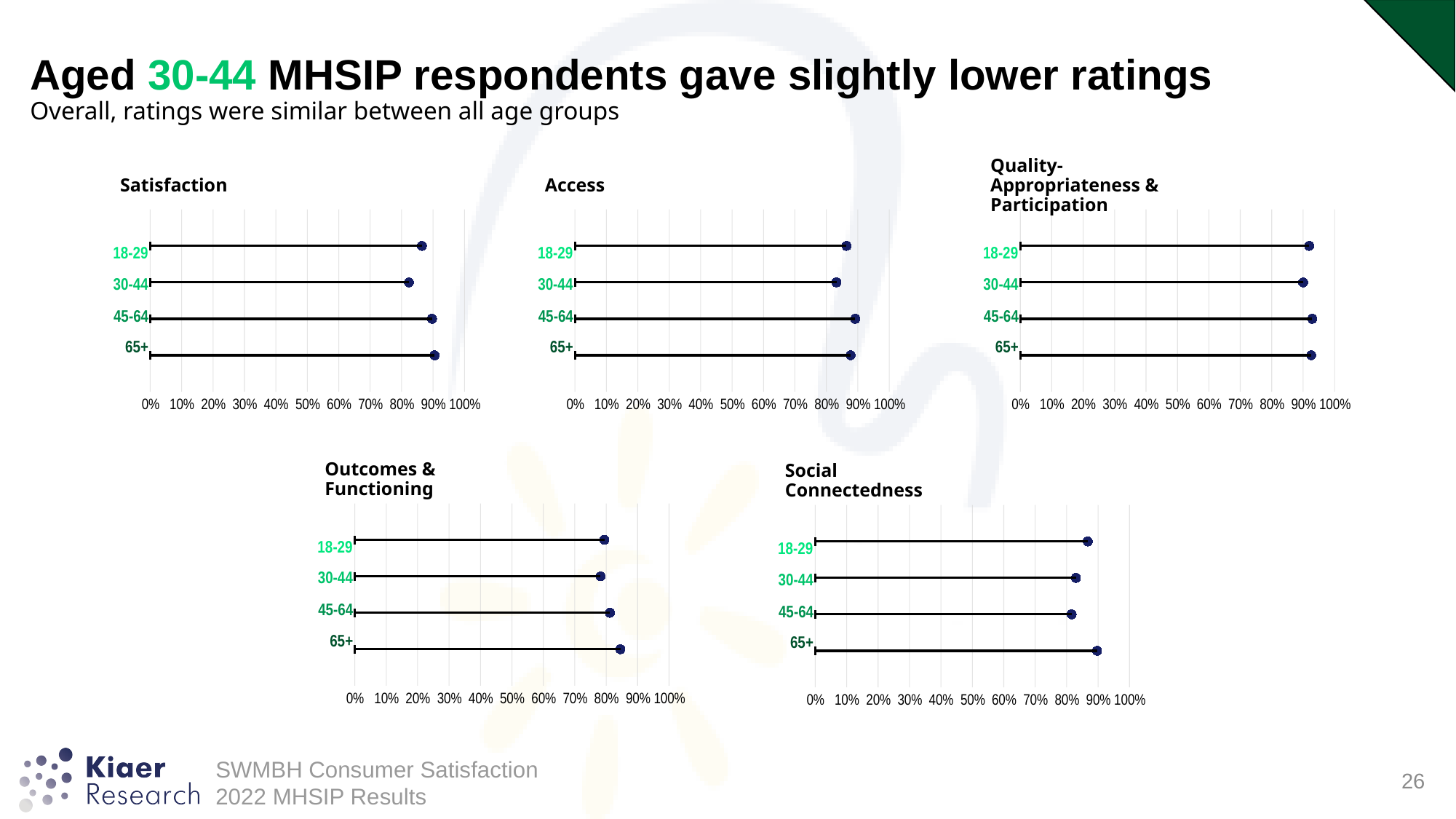
In the Social Connectedness chart, is the value for 45-64 greater or less than 90%? less In the Access chart, is the value for 45-64 greater or less than 70%? greater In the Outcomes & Functioning chart, which age group has the highest rating? 65+ How many age groups are shown in the Satisfaction chart? 4 In the Outcomes & Functioning chart, is the value for 30-44 greater or less than 90%? less In the Access chart, which age group has the lowest rating? 30-44 In the Social Connectedness chart, which age group has the highest rating? 65+ What kind of chart is the Access chart? lollipop chart (dot plot with lines) In the Satisfaction chart, which age group has the lowest rating? 30-44 How many charts are shown on the slide? 5